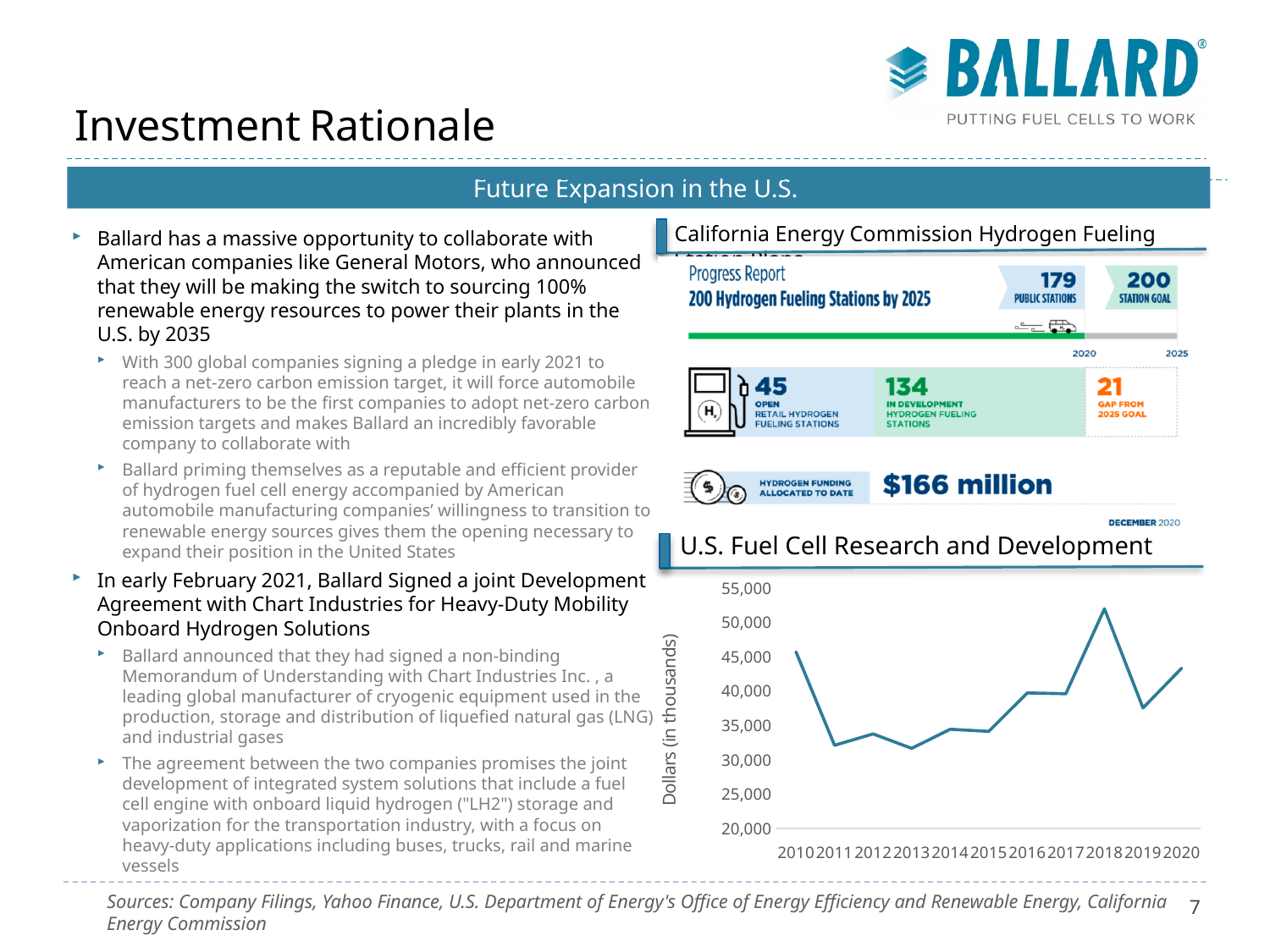
What kind of chart is the U.S. Fuel Cell Research and Development chart? line chart In the U.S. Fuel Cell Research and Development chart, how many years are plotted on the x axis? 11 In the U.S. Fuel Cell Research and Development chart, is the value for 2019 greater or less than 40,000? less In the U.S. Fuel Cell Research and Development chart, is the value for 2016 greater or less than 35,000? greater In the U.S. Fuel Cell Research and Development chart, is the value for 2018 greater or less than 50,000? greater In the U.S. Fuel Cell Research and Development chart, which year has the highest value? 2018 In the U.S. Fuel Cell Research and Development chart, which is larger, the value for 2016 or the value for 2012? 2016 What is the y-axis label of the U.S. Fuel Cell Research and Development chart? Dollars (in thousands) In the U.S. Fuel Cell Research and Development chart, does the value rise or fall from 2010 to 2011? fall In the U.S. Fuel Cell Research and Development chart, which is larger, the value for 2018 or the value for 2010? 2018